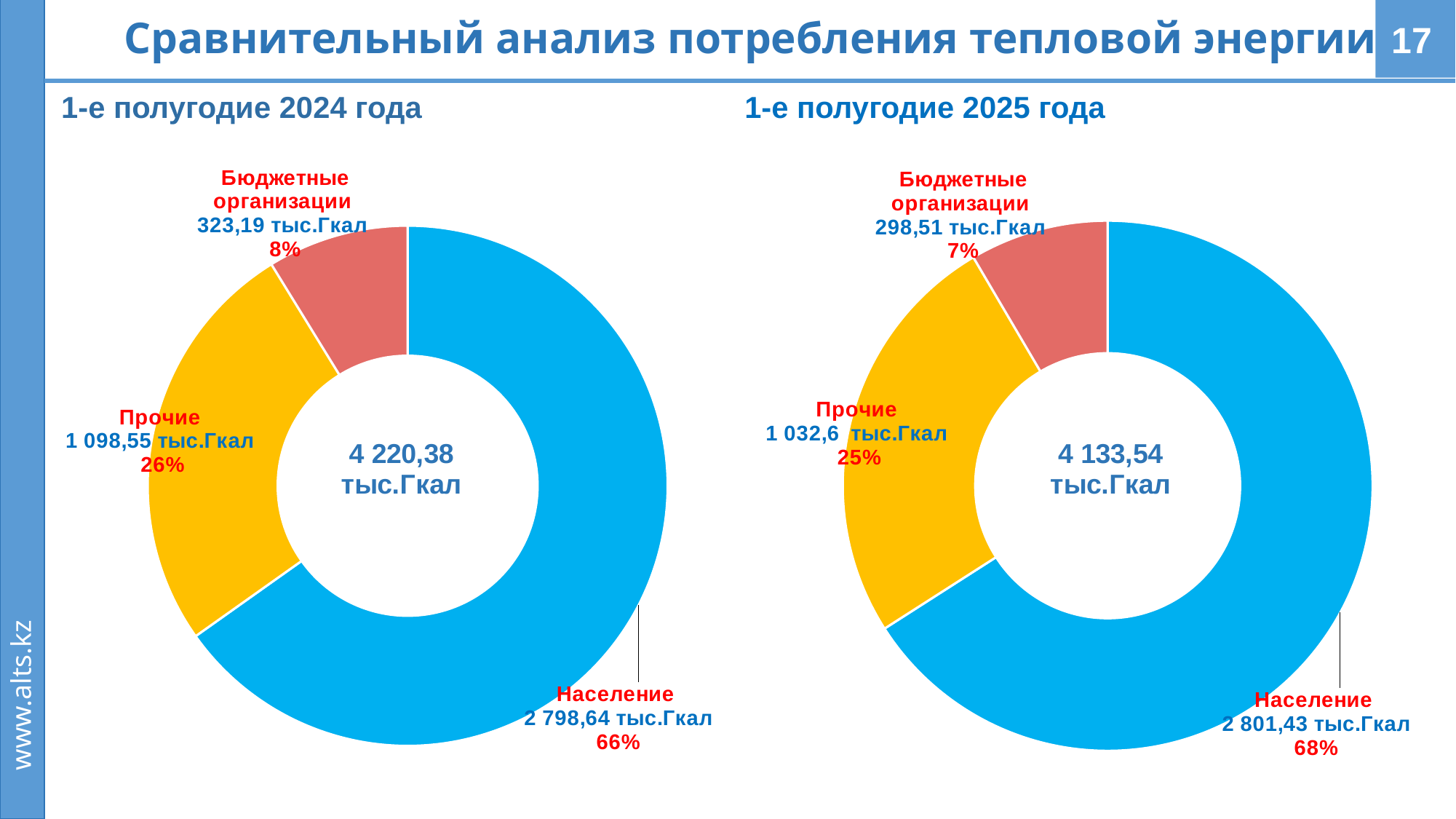
In the '1-е полугодие 2025 года' chart, which category has the largest value? Население How many categories does the '1-е полугодие 2024 года' chart show? 3 Which is larger: Прочие in the '1-е полугодие 2024 года' chart or Прочие in the '1-е полугодие 2025 года' chart? 1-е полугодие 2024 года In the '1-е полугодие 2024 года' chart, what share of the total does Население account for? 66% In the '1-е полугодие 2025 года' chart, what share of the total does Прочие account for? 25% What is the total shown in the centre of the '1-е полугодие 2025 года' chart? 4 133,54 тыс.Гкал What is the total shown in the centre of the '1-е полугодие 2024 года' chart? 4 220,38 тыс.Гкал In the '1-е полугодие 2025 года' chart, what colour is the Население segment? Blue In the '1-е полугодие 2024 года' chart, what is the value for Население? 2 798,64 тыс.Гкал In the '1-е полугодие 2024 года' chart, which category has the smallest value? Бюджетные организации What kind of chart is used for '1-е полугодие 2025 года'? Donut (pie) chart In the '1-е полугодие 2025 года' chart, what is the value for Бюджетные организации? 298,51 тыс.Гкал